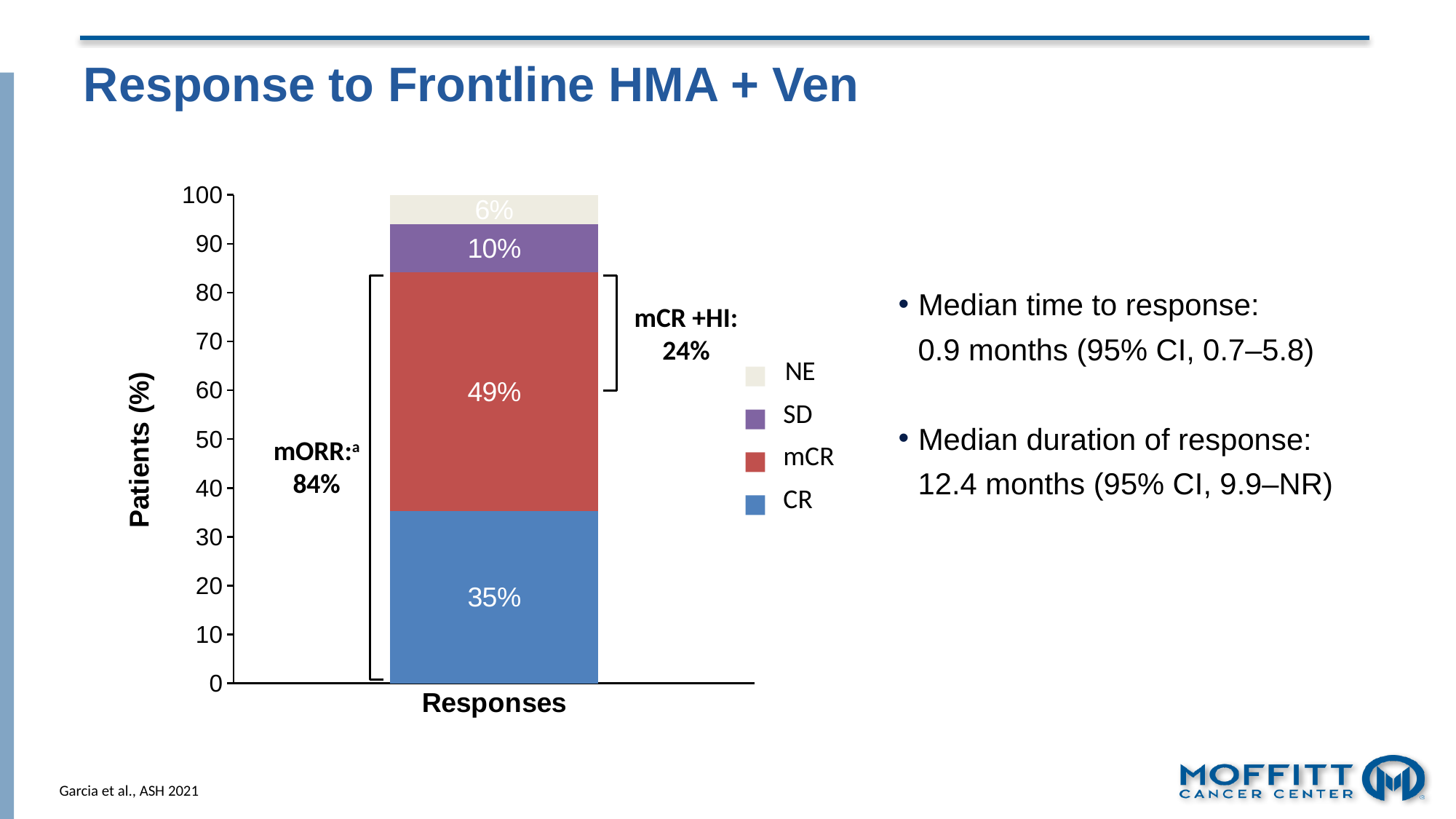
How many series does the legend list? 4 Which response category has the smallest share of patients? NE What percentage of patients achieved CR? 35% What is the difference in percentage points between mCR and CR? 14 What percentage of patients achieved mCR? 49% Which is larger, the CR segment or the SD segment? CR What percentage of patients had SD? 10% What is the y-axis label of the chart? Patients (%) What is the total of the stacked bar? 100% What percentage of patients were NE? 6% Which response category has the largest share of patients? mCR What kind of chart is shown? Stacked bar chart